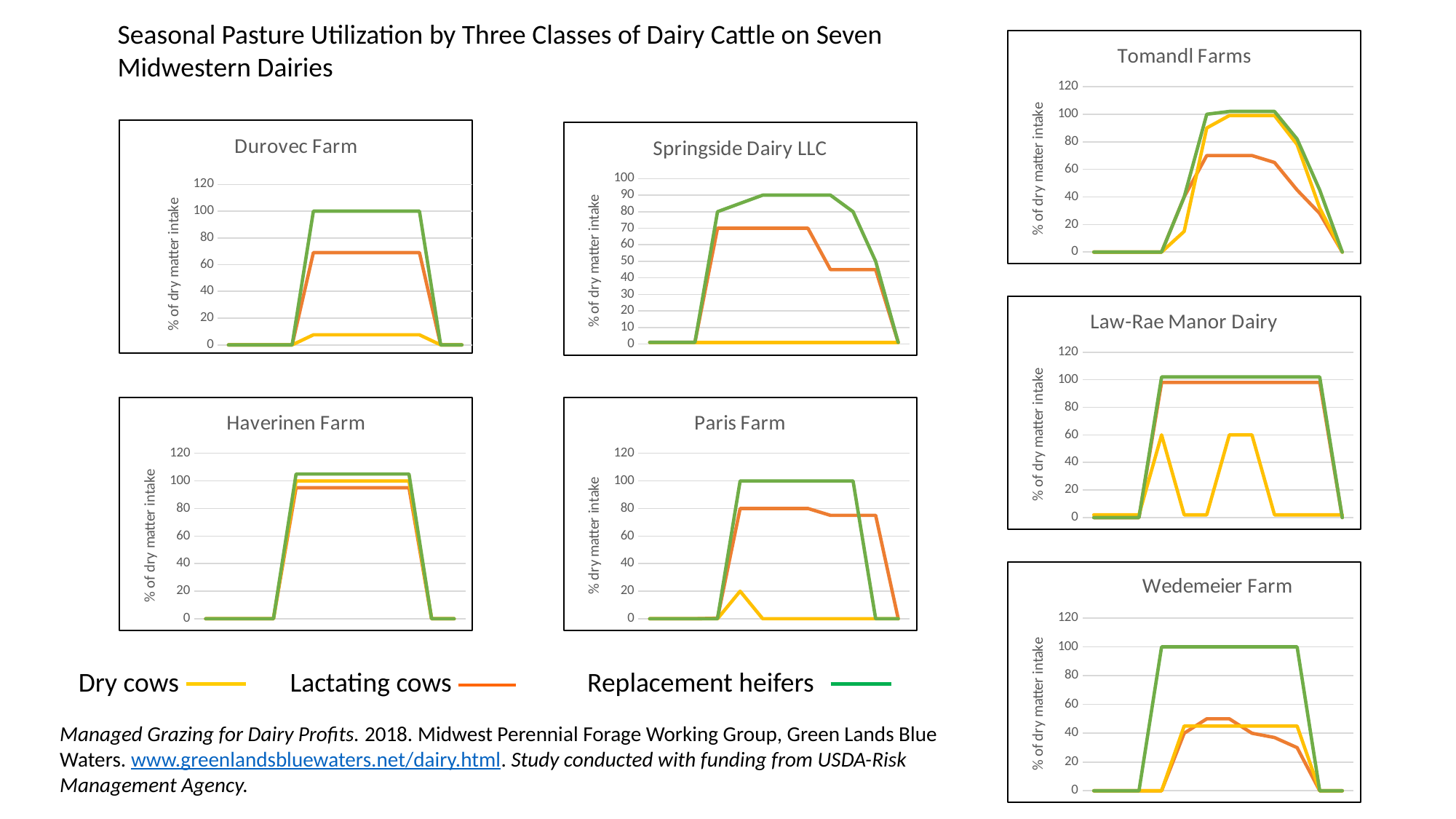
In the Springside Dairy LLC chart, what is the peak value reached by the Replacement heifers line? 90 In the Springside Dairy LLC chart, what value does the Lactating cows line plateau at before it drops? 70 In the Durovec Farm chart, which series reaches the highest value? Replacement heifers How many series does the shared legend list? 3 How many farm charts are shown on the slide? 7 What kind of chart is the Durovec Farm chart? line chart In the Durovec Farm chart, which series has the lowest peak value? Dry cows In the Wedemeier Farm chart, is the peak value for Lactating cows greater or less than 60? less Which colour represents Dry cows in the legend? yellow In the Wedemeier Farm chart, what value does the Replacement heifers line plateau at? 100 In the Paris Farm chart, what is the peak value of the Dry cows line? 20 In the Paris Farm chart, which series has a higher plateau, Lactating cows or Replacement heifers? Replacement heifers